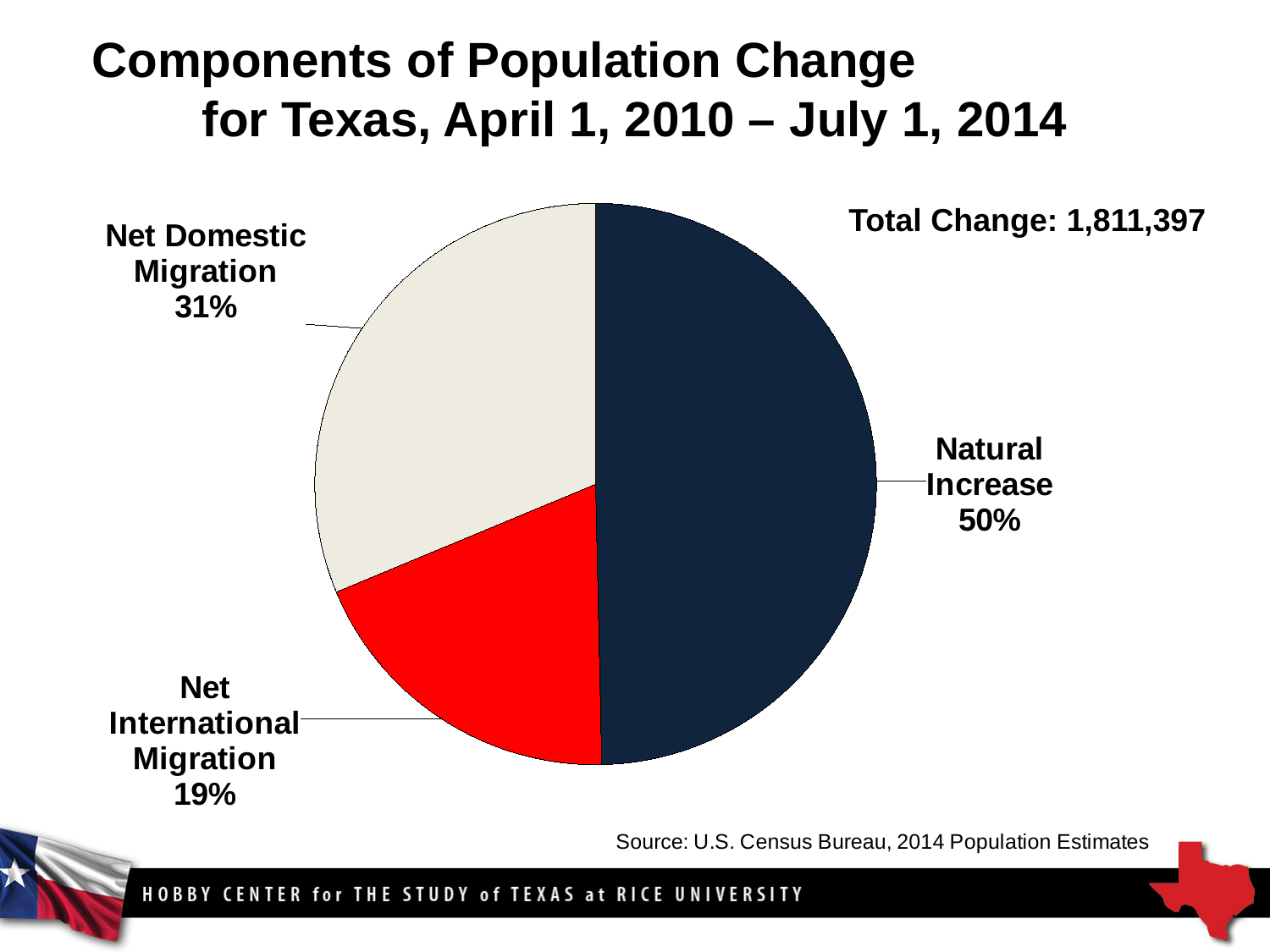
What colour is the Net International Migration slice? red Which component has the smallest share of the pie? Net International Migration What kind of chart is shown on the slide? pie chart How many slices does the pie chart have? 3 What share of the pie does Natural Increase account for? 50% What is the difference in percentage points between Natural Increase and Net Domestic Migration? 19 What share of the pie does Net Domestic Migration account for? 31% What share of the pie does Net International Migration account for? 19% What is the total change stated on the slide? 1,811,397 Which component has the largest share of the pie? Natural Increase Which is larger, the share for Net Domestic Migration or the share for Net International Migration? Net Domestic Migration What is the difference in percentage points between Net Domestic Migration and Net International Migration? 12